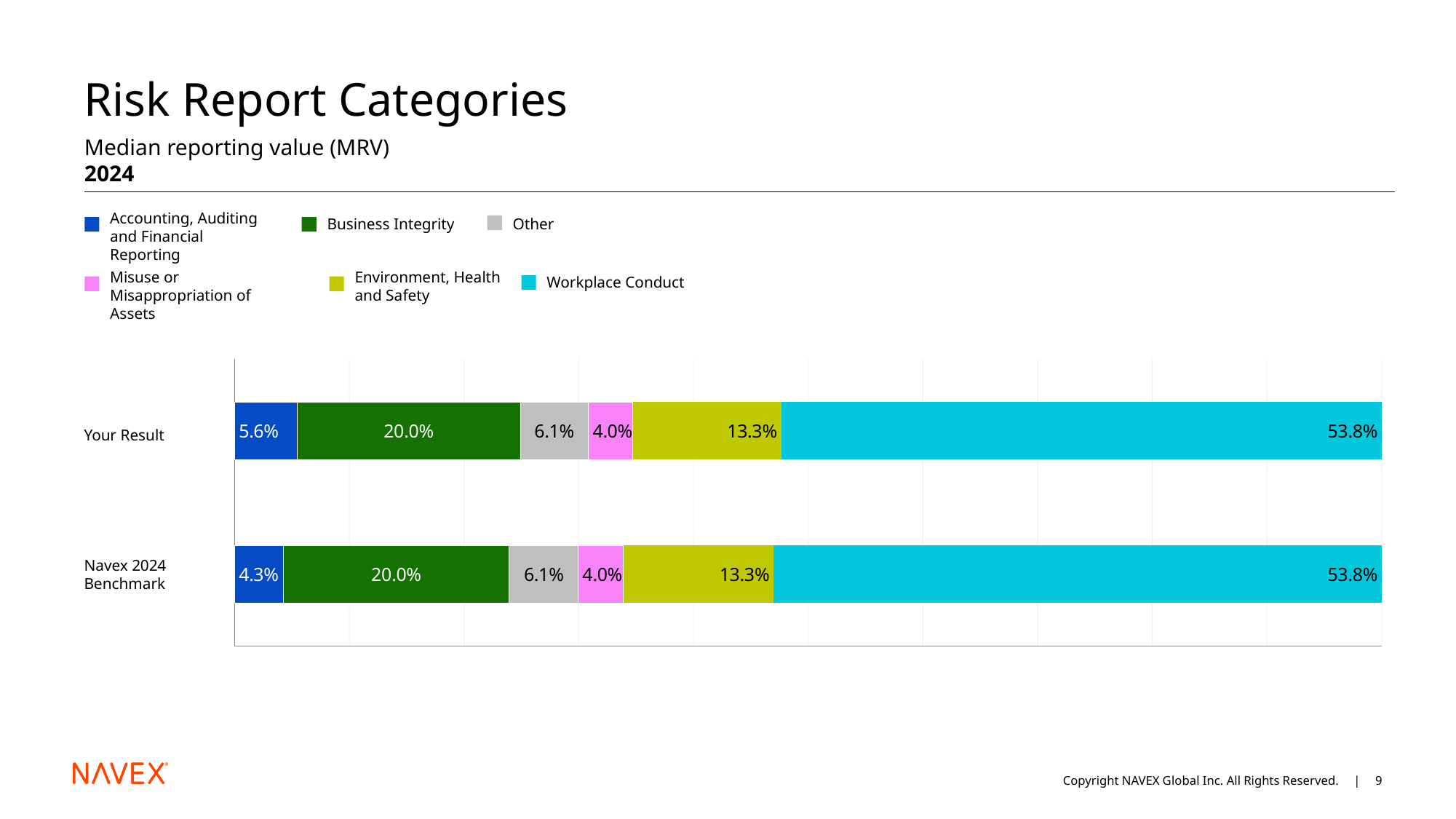
How many series does the legend list? 6 What is the difference between the Accounting, Auditing and Financial Reporting values for Your Result and the Navex 2024 Benchmark? 1.3% Which segment is the smallest in the Navex 2024 Benchmark bar? Misuse or Misappropriation of Assets What is the Environment, Health and Safety value for the Navex 2024 Benchmark? 13.3% How many bars (categories) are plotted in the chart? 2 What kind of chart is shown on the slide? Stacked bar chart What is the Accounting, Auditing and Financial Reporting value for Your Result? 5.6% What is the Workplace Conduct value for Your Result? 53.8% Which is larger: the Business Integrity value for Your Result or the Other value for Your Result? Business Integrity What colour represents Workplace Conduct in the legend? Cyan What is the Accounting, Auditing and Financial Reporting value for the Navex 2024 Benchmark? 4.3%